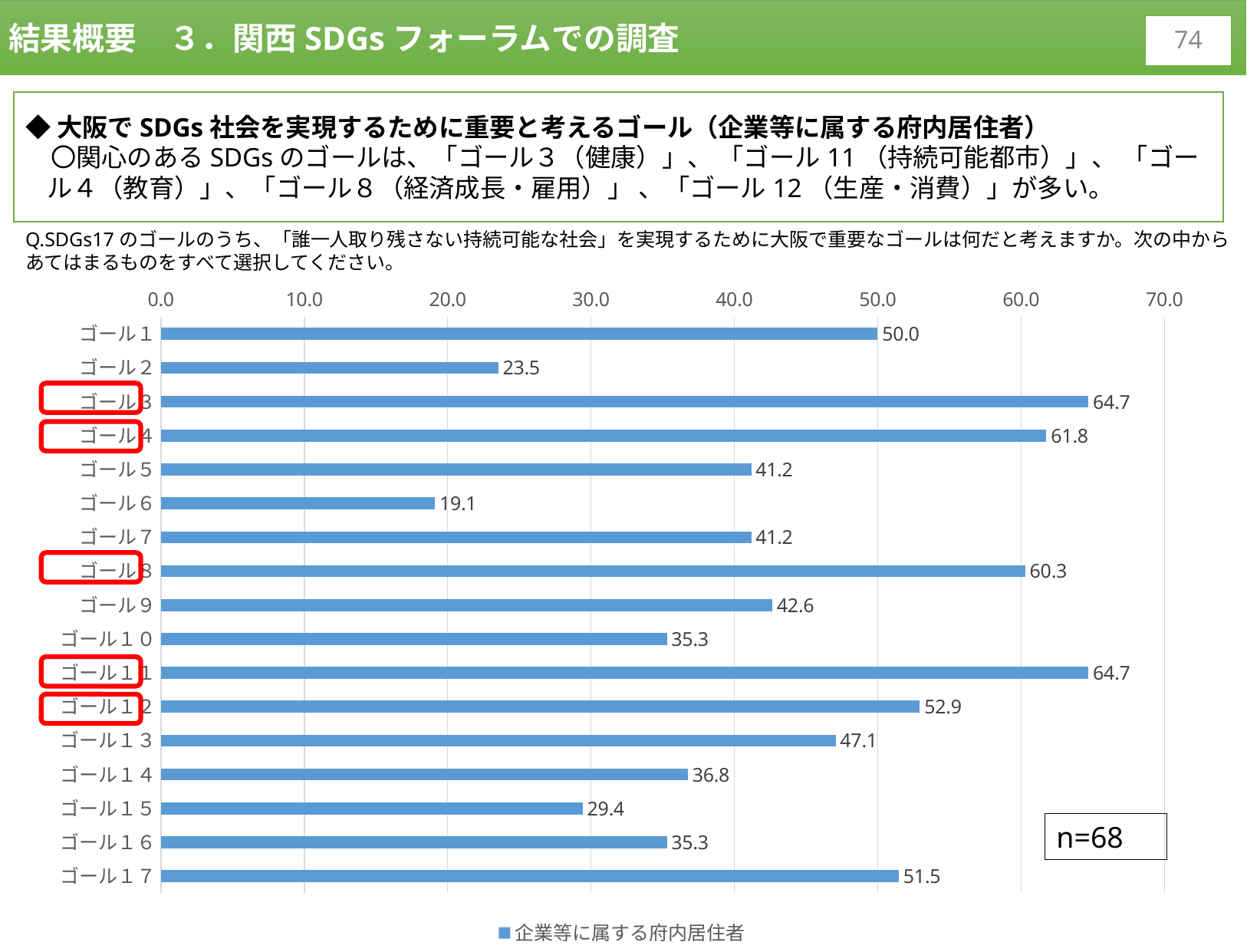
What is the difference between the values for ゴール３ and ゴール４? 2.9 What kind of chart is shown on the slide? Bar chart What is the value for ゴール１２ in the chart? 52.9 What is the value for ゴール１ in the chart? 50.0 Is the value for ゴール１３ greater or less than 40.0? greater How many series does the legend list? 1 How many goals (categories) are shown in the chart? 17 What is the value for ゴール６ in the chart? 19.1 Which has a larger value, ゴール２ or ゴール１４? ゴール１４ What is the difference between the values for ゴール１７ and ゴール１５? 22.1 Which has a larger value, ゴール８ or ゴール９? ゴール８ Which goal has the lowest value in the chart? ゴール６